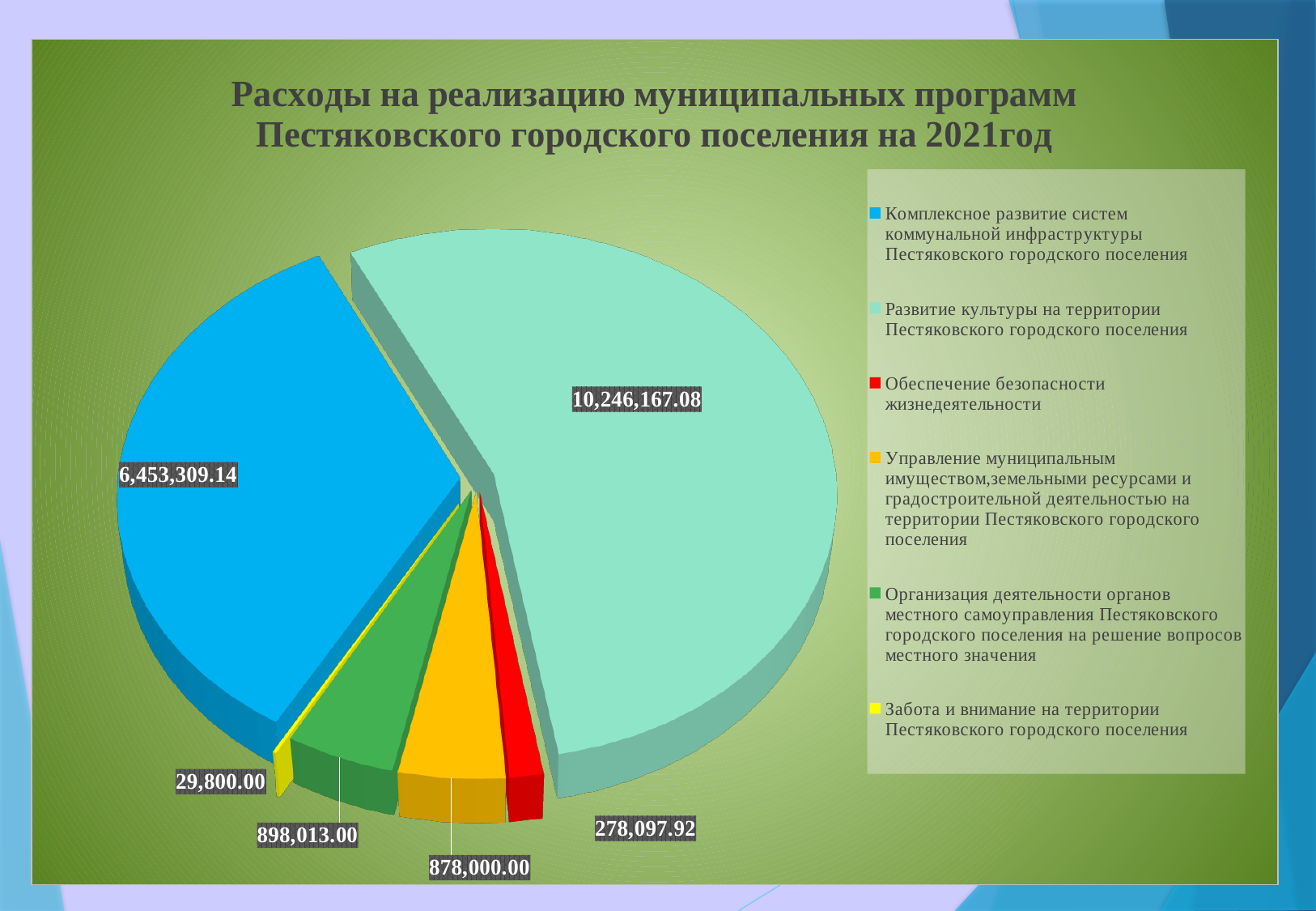
Which category has the largest slice of the pie? Развитие культуры на территории Пестяковского городского поселения How many categories does the legend list? 6 What kind of chart is shown on the slide? Pie chart Which category has the smallest slice of the pie? Забота и внимание на территории Пестяковского городского поселения What is the value for "Комплексное развитие систем коммунальной инфраструктуры Пестяковского городского поселения"? 6,453,309.14 What is the value for "Забота и внимание на территории Пестяковского городского поселения"? 29,800.00 What colour is the slice for "Обеспечение безопасности жизнедеятельности"? Red What is the value for "Развитие культуры на территории Пестяковского городского поселения"? 10,246,167.08 What is the value for "Обеспечение безопасности жизнедеятельности"? 278,097.92 Which is larger: the value for "Организация деятельности органов местного самоуправления" or the value for "Управление муниципальным имуществом"? Организация деятельности органов местного самоуправления What is the difference between the values for "Развитие культуры" and "Комплексное развитие систем коммунальной инфраструктуры"? 3,792,857.94 What is the difference between the values for "Организация деятельности органов местного самоуправления" and "Управление муниципальным имуществом"? 20,013.00